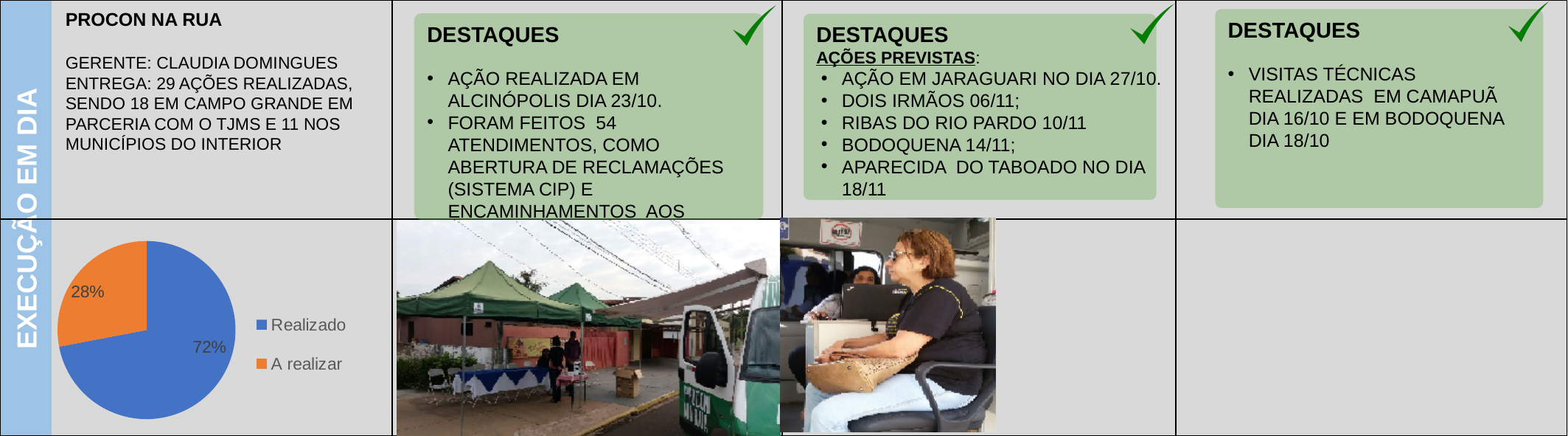
What is the difference in percentage points between the "Realizado" and "A realizar" slices? 44 What share of the pie is labelled "Realizado"? 72% Which slice of the pie chart is the largest? Realizado Which slice of the pie chart is the smallest? A realizar What share of the pie is labelled "A realizar"? 28% Which is larger, the "Realizado" slice or the "A realizar" slice? Realizado Is the share for "A realizar" greater or less than 50%? less What colour is the "A realizar" slice in the pie chart? orange How many slices does the pie chart have? 2 What kind of chart is shown on the slide? pie chart How many entries does the legend of the pie chart list? 2 What colour is the "Realizado" slice in the pie chart? blue